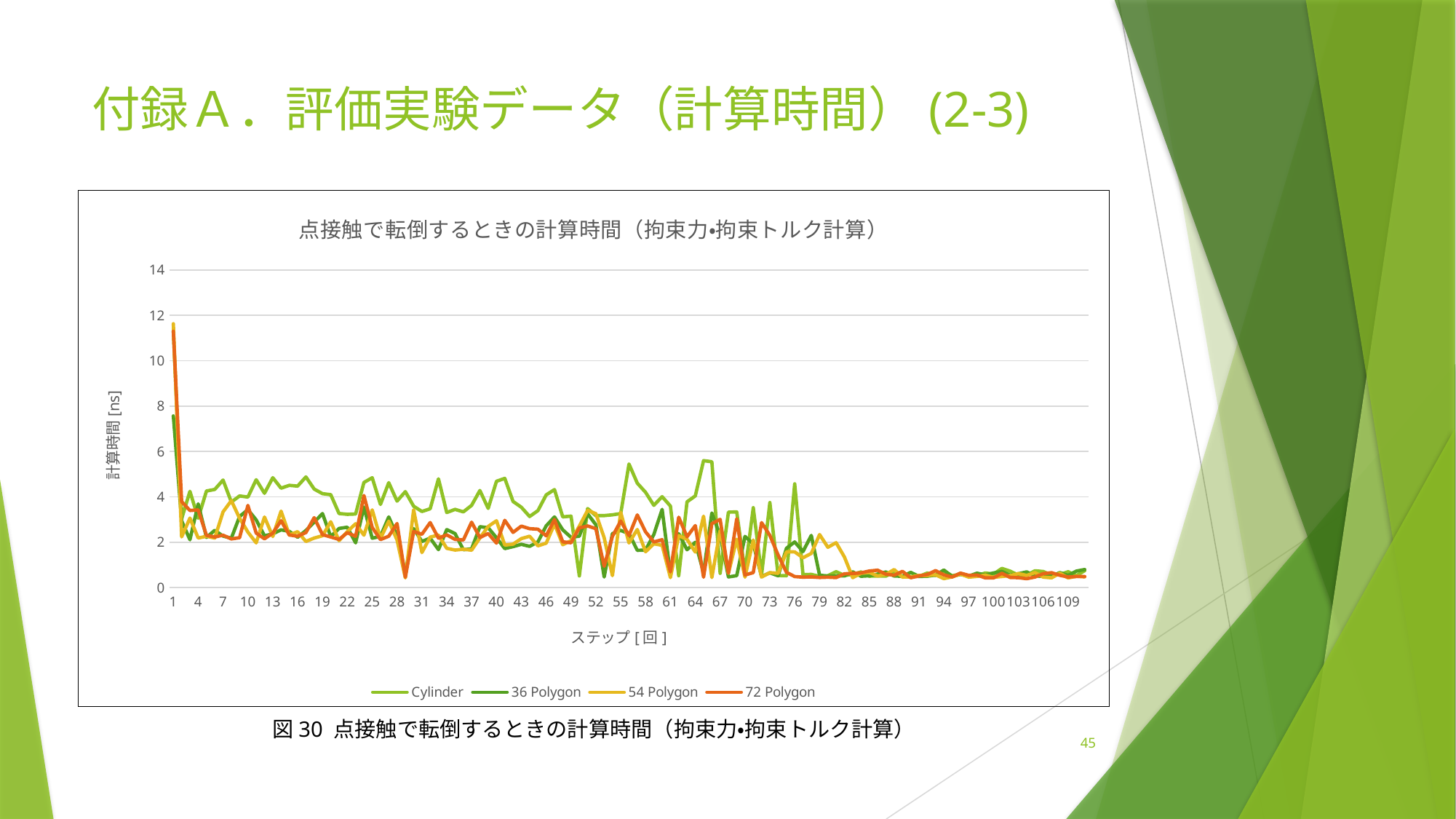
What is the title of the chart? 点接触で転倒するときの計算時間（拘束力•拘束トルク計算） Is the value for 54 Polygon at step 1 greater or less than 10? greater How many series does the legend list? 4 Do the values generally rise or fall as the step number increases? fall Is the value for 36 Polygon at step 1 greater or less than 6? greater Is the value for Cylinder at step 100 greater or less than 2? less Between steps 4 and 46, which series is generally the highest? Cylinder What kind of chart is shown on the slide? line chart What is the label of the vertical axis? 計算時間 [ns]